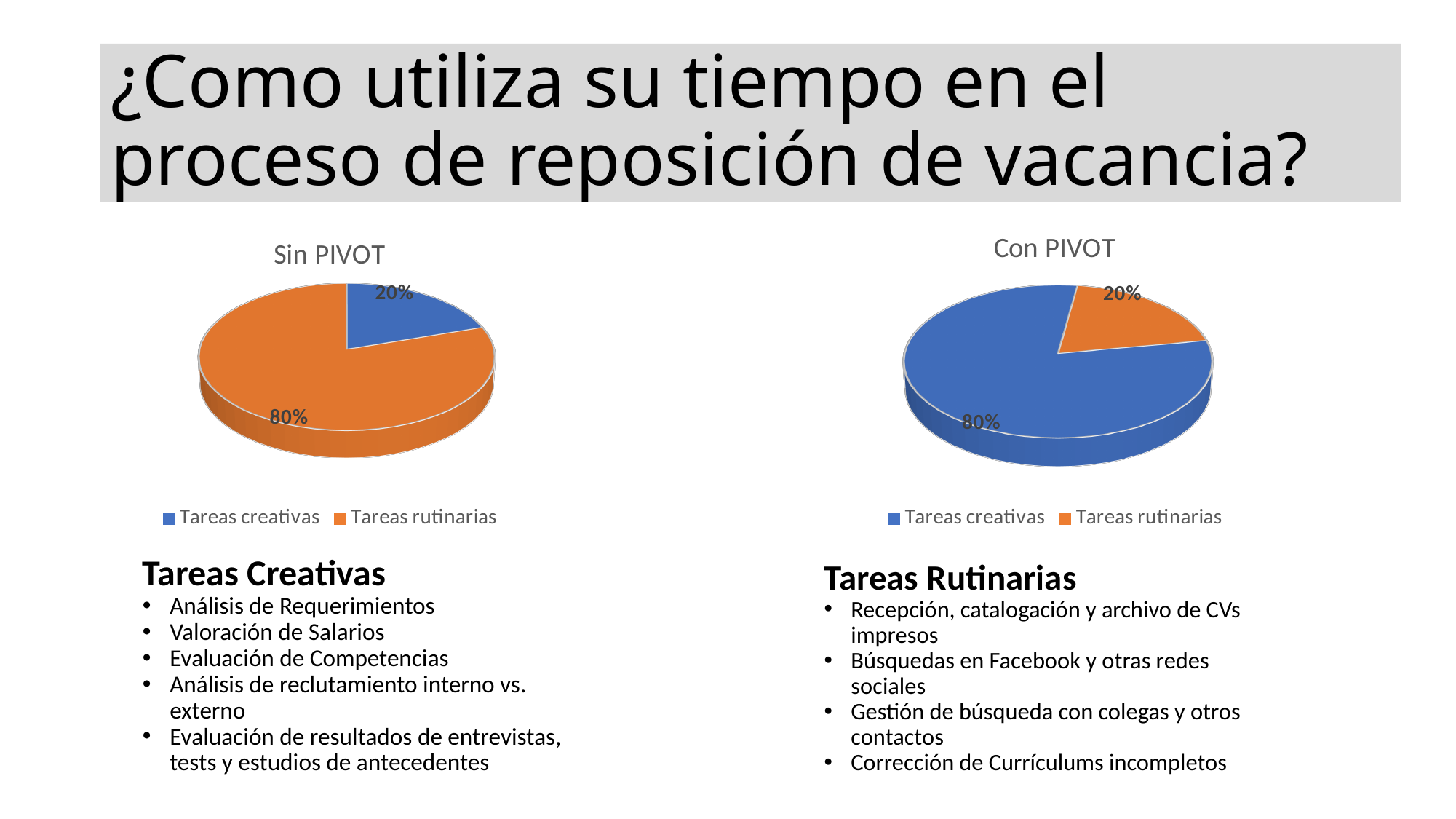
How many categories does the 'Con PIVOT' chart show? 2 In the 'Sin PIVOT' chart, what colour represents Tareas rutinarias? Orange In the 'Sin PIVOT' chart, what share of time goes to Tareas creativas? 20% In the 'Sin PIVOT' chart, what is the difference between the Tareas rutinarias and Tareas creativas shares? 60% What is the title of the chart on the right side of the slide? Con PIVOT In the 'Con PIVOT' chart, what share of time goes to Tareas creativas? 80% In the 'Sin PIVOT' chart, which category has the largest slice? Tareas rutinarias In the 'Con PIVOT' chart, which is larger: Tareas creativas or Tareas rutinarias? Tareas creativas What type of chart is the 'Sin PIVOT' chart? Pie chart In the 'Con PIVOT' chart, which category has the smallest slice? Tareas rutinarias In the 'Con PIVOT' chart, what share of time goes to Tareas rutinarias? 20% In the 'Sin PIVOT' chart, what share of time goes to Tareas rutinarias? 80%